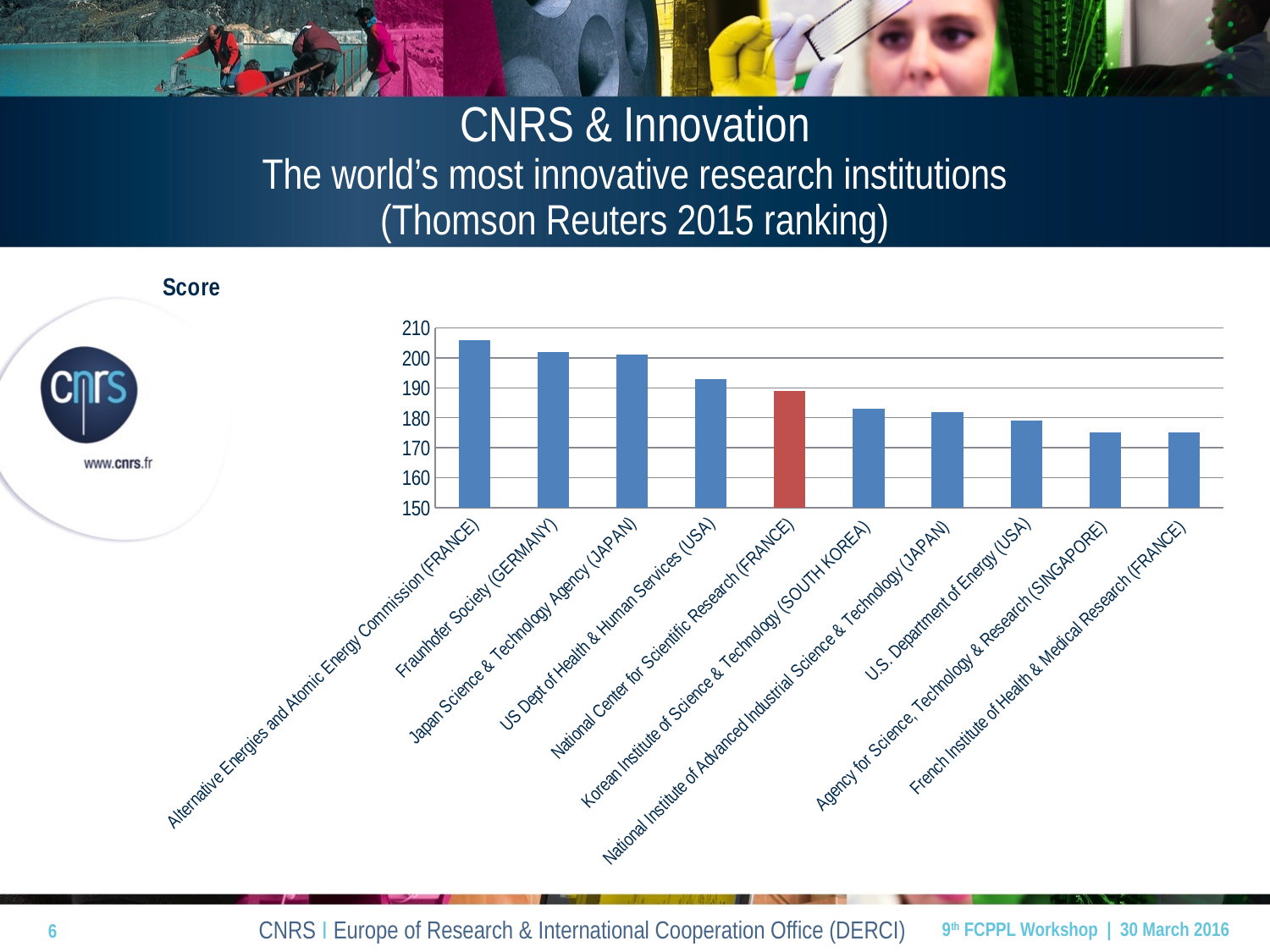
Is the score for French Institute of Health & Medical Research (FRANCE) greater or less than 180? less Do the scores rise or fall moving from left to right along the x axis? fall Which institution's bar is coloured red in the chart? National Center for Scientific Research (FRANCE) What kind of chart is shown on the slide? bar chart Which institution has the highest score in the chart? Alternative Energies and Atomic Energy Commission (FRANCE) Which has a higher score: US Dept of Health & Human Services (USA) or Korean Institute of Science & Technology (SOUTH KOREA)? US Dept of Health & Human Services (USA) Which has a higher score: Alternative Energies and Atomic Energy Commission (FRANCE) or National Center for Scientific Research (FRANCE)? Alternative Energies and Atomic Energy Commission (FRANCE) Is the score for Alternative Energies and Atomic Energy Commission (FRANCE) greater or less than 200? greater Is the score for US Dept of Health & Human Services (USA) greater or less than 190? greater How many institutions are plotted in the chart? 10